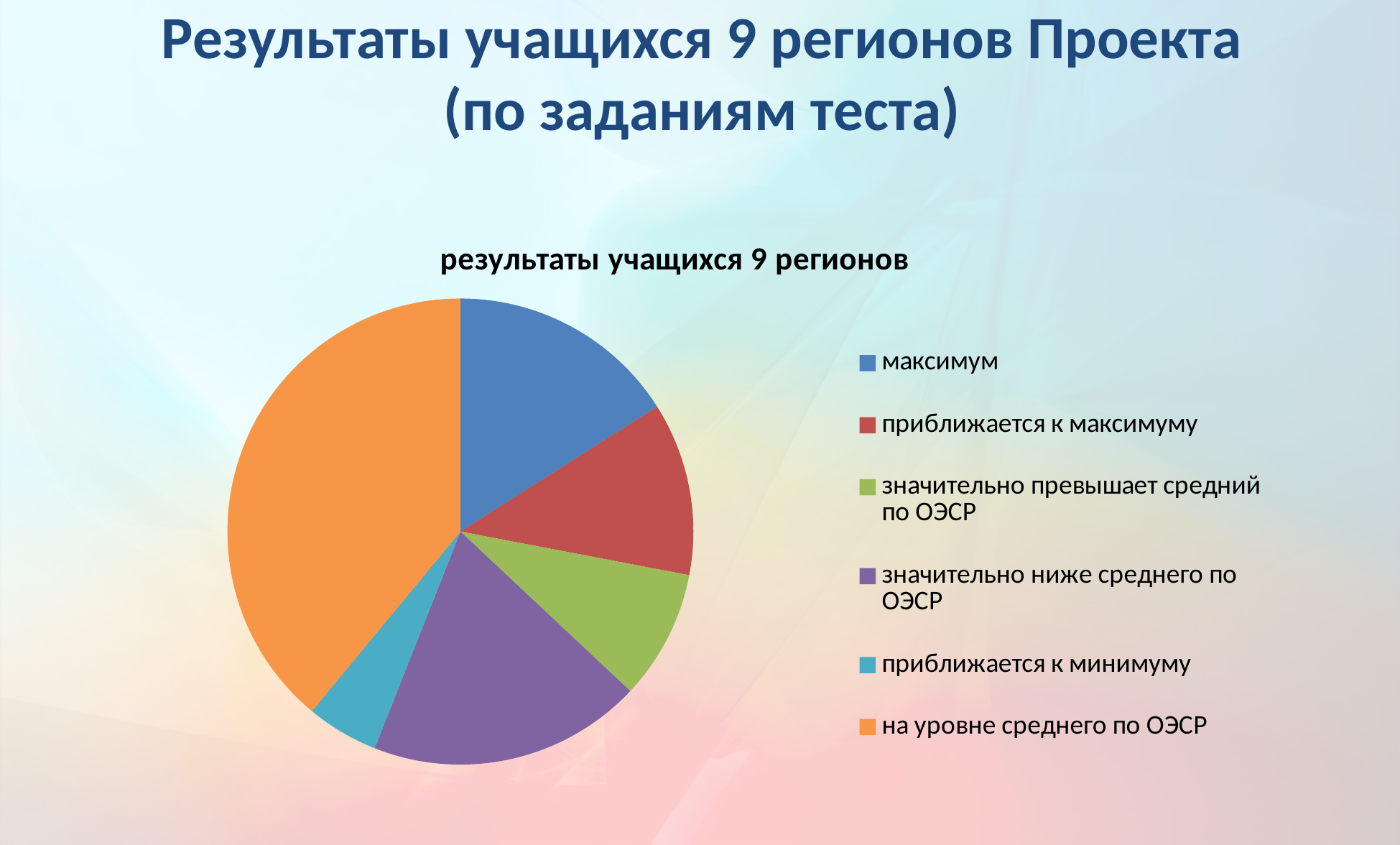
Which category has the smallest slice of the pie? приближается к минимуму How many slices does the pie chart have? 6 Which slice is larger: "на уровне среднего по ОЭСР" or "максимум"? на уровне среднего по ОЭСР Which slice is larger: "максимум" or "значительно превышает средний по ОЭСР"? максимум What kind of chart is shown on the slide? pie chart How many entries does the legend list? 6 What is the title of the chart? результаты учащихся 9 регионов Which category has the largest slice of the pie? на уровне среднего по ОЭСР Which slice is larger: "значительно ниже среднего по ОЭСР" or "приближается к минимуму"? значительно ниже среднего по ОЭСР What colour is the slice for "приближается к максимуму"? red